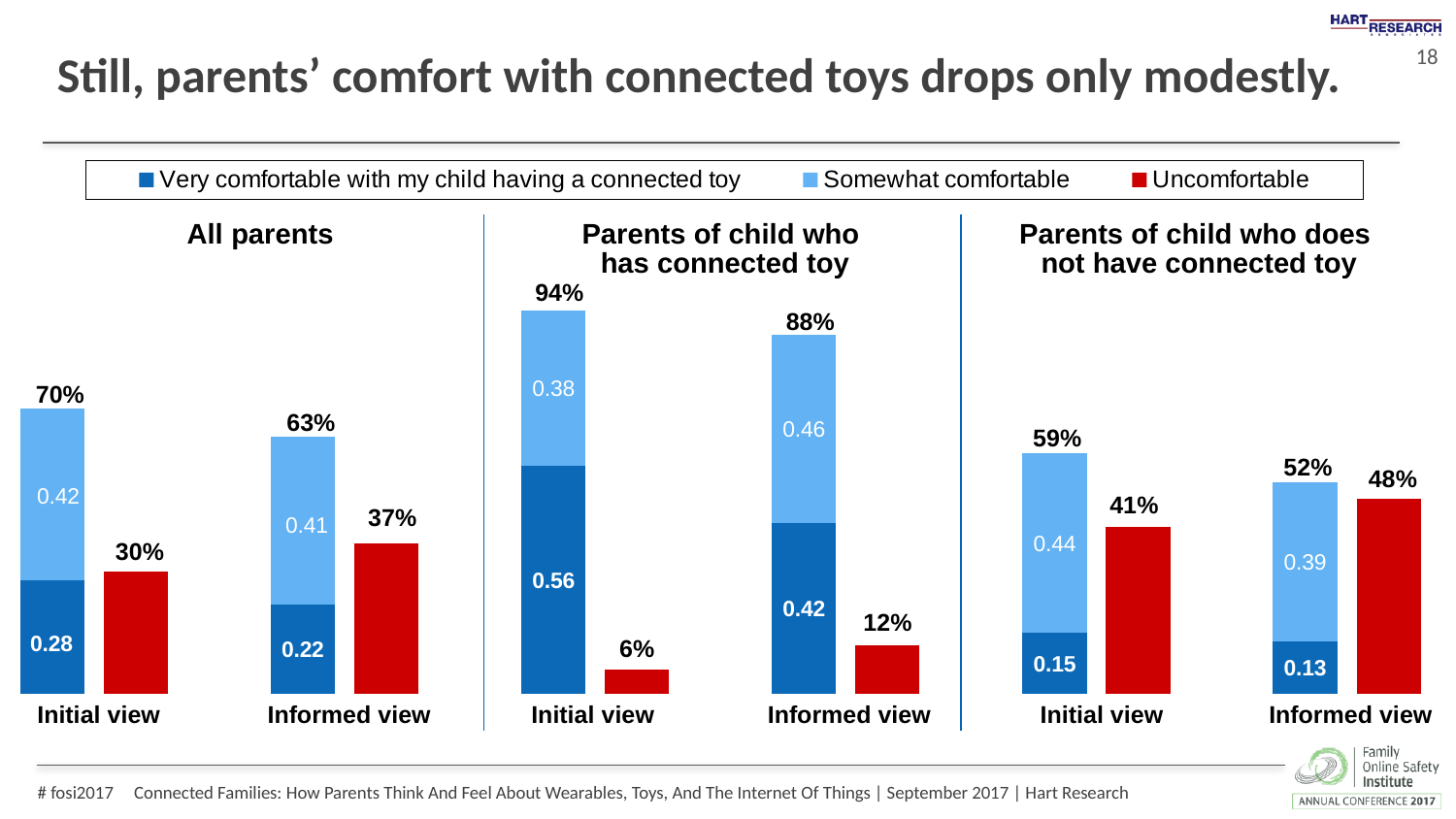
What is the Somewhat comfortable value for the Initial view among Parents of child who does not have connected toy? 0.44 What is the combined comfortable total (Very plus Somewhat) shown above the Initial view bar for Parents of child who has connected toy? 94% What kind of chart is shown on the slide? Stacked bar chart What is the Uncomfortable value for the Informed view among Parents of child who has connected toy? 12% What is the 'Very comfortable with my child having a connected toy' value for the Initial view among All parents? 0.28 Which group has the lowest Uncomfortable value in the Initial view? Parents of child who has connected toy How many series does the legend list? 3 Among Parents of child who has connected toy, is the 'Very comfortable' value larger in the Initial view or the Informed view? Initial view What is the difference between the Uncomfortable values for the Initial view and the Informed view among All parents? 7% What colour represents the Uncomfortable series in the legend? Red Does the combined comfortable total fall or rise from the Initial view to the Informed view for Parents of child who does not have connected toy? Fall Which group has the highest Uncomfortable value in the Informed view? Parents of child who does not have connected toy